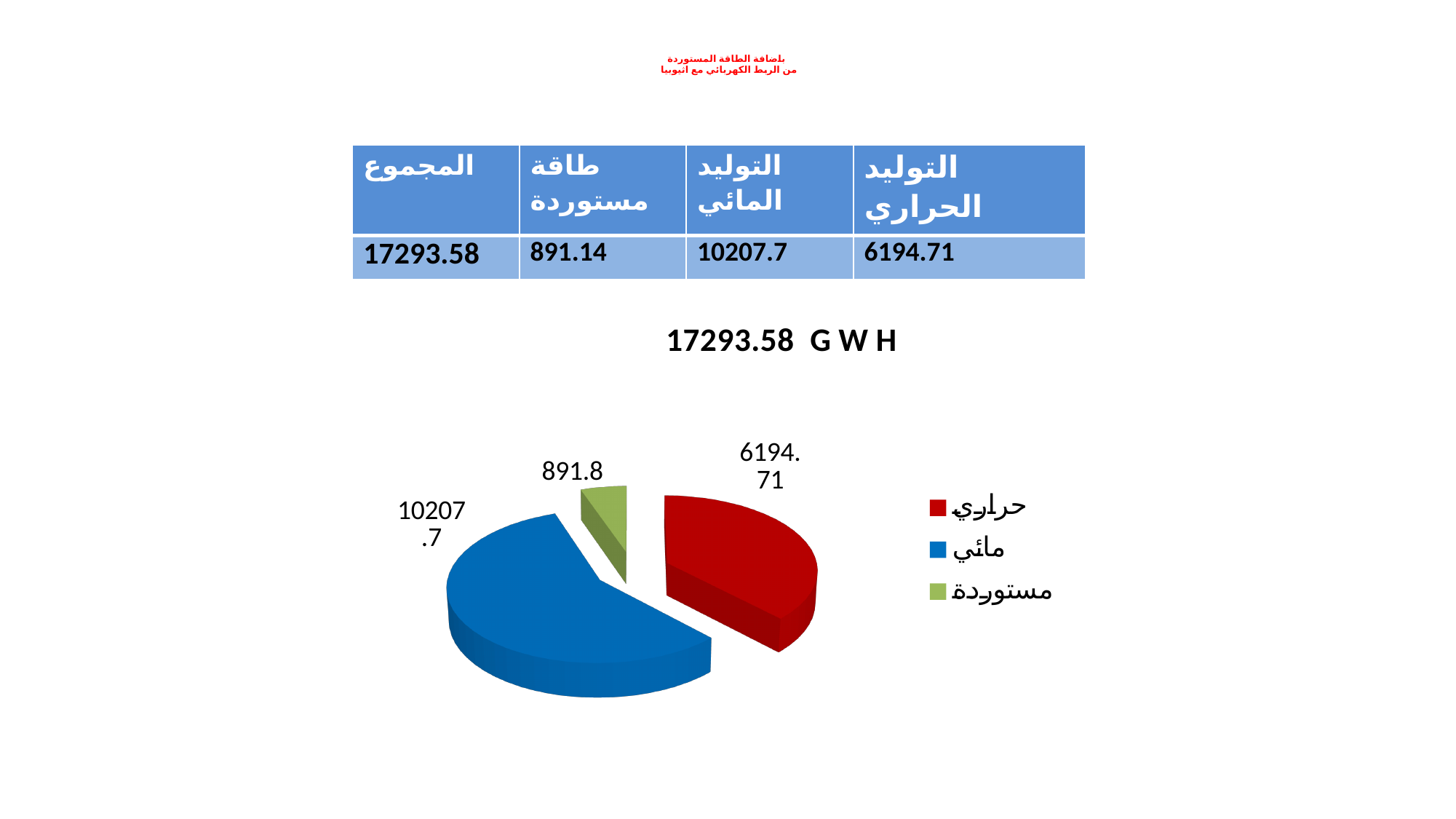
What is the value of the حراري slice in the pie chart? 6194.71 What kind of chart is shown on the slide? pie chart What is the value of the مستوردة slice in the pie chart? 891.8 What is the difference between the مائي and حراري values in the pie chart? 4012.99 Which slice of the pie chart is the smallest? مستوردة What is the difference between the حراري and مستوردة values in the pie chart? 5302.91 Which slice of the pie chart is the largest? مائي How many slices does the pie chart have? 3 Which is larger in the pie chart, حراري or مائي? مائي What is the value of the مائي slice in the pie chart? 10207.7 How many entries does the pie chart legend list? 3 What colour is the مائي slice in the pie chart? blue